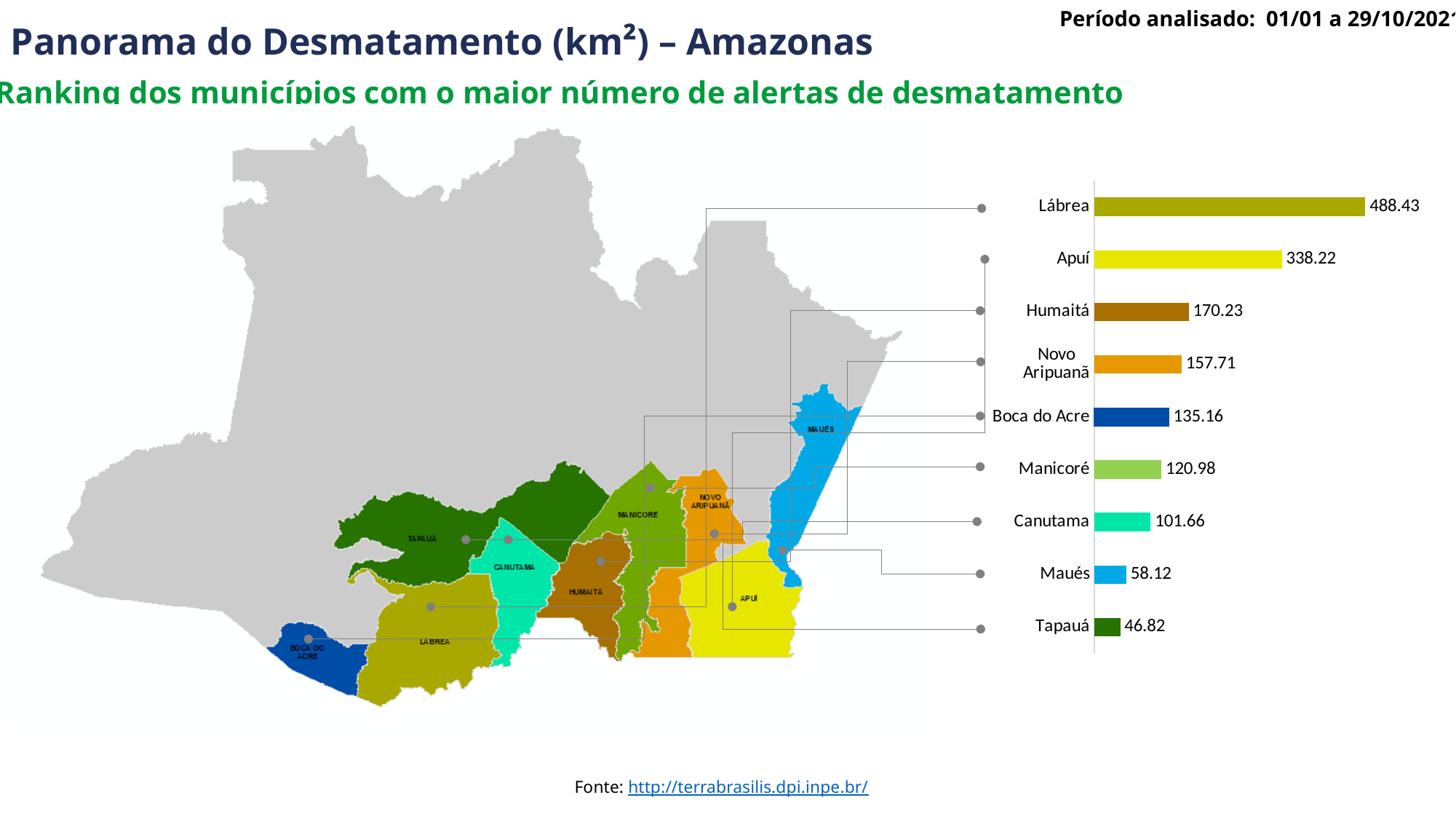
How many municipalities are shown in the bar chart? 9 Which municipality has the highest value in the bar chart? Lábrea Which has a larger value, Maués or Tapauá? Maués Which has a larger value, Boca do Acre or Manicoré? Boca do Acre What is the value shown for Maués? 58.12 What value is shown for Novo Aripuanã? 157.71 What is the difference between the values for Lábrea and Apuí? 150.21 What value is shown for Canutama? 101.66 What kind of chart is used to rank the municipalities? Bar chart Which municipality has the lowest value in the bar chart? Tapauá What is the difference between the values for Humaitá and Novo Aripuanã? 12.52 What is the deforestation value shown for Lábrea? 488.43